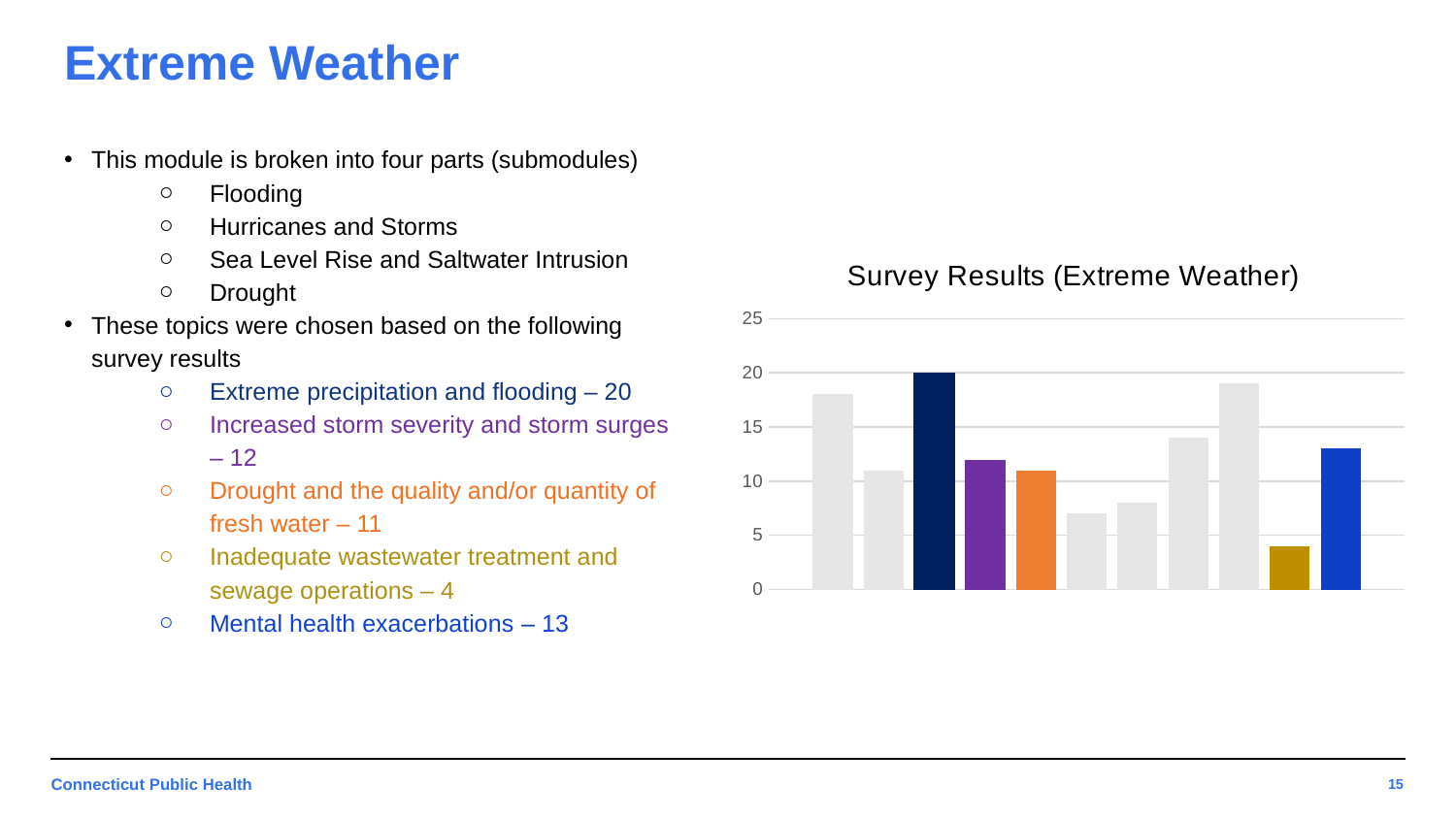
Which bar is the tallest in the chart? the dark navy bar (third bar) How many bars are plotted in the chart? 11 What is the title of the chart on the slide? Survey Results (Extreme Weather) What value does the dark navy bar reach on the y axis? 20 What kind of chart is shown on the slide? bar chart Is the value of the blue bar (last bar) greater or less than 15? less Is the value of the gold bar greater or less than 5? less What is the highest value shown on the y axis of the chart? 25 Is the value of the purple bar greater or less than 10? greater Which is taller, the purple bar or the orange bar? the purple bar Which bar is the shortest in the chart? the gold bar (tenth bar)